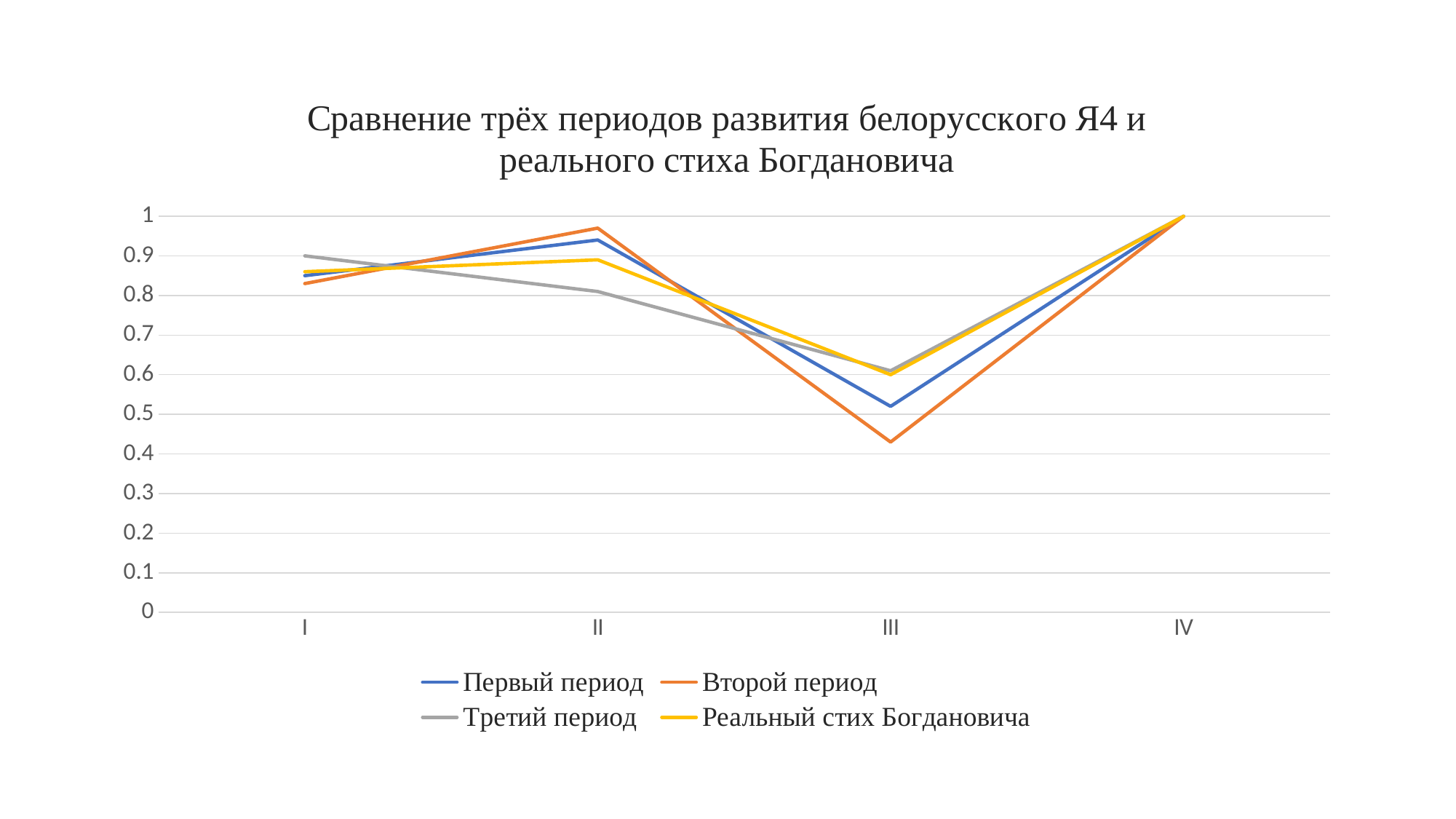
What is the value of Третий период at category I? 0.9 Is the value for Третий период at category II greater or less than 0.7? greater Is the value for Второй период at category III greater or less than 0.5? less Does the Второй период line rise or fall from category II to category III? fall What kind of chart is shown on the slide? line chart What is the value of Первый период at category IV? 1 Which series has the lowest value at category III? Второй период Is the value for Второй период at category II greater or less than 0.9? greater How many categories are shown on the x axis? 4 At category III, which is larger: Первый период or Второй период? Первый период How many series does the legend list? 4 Which series has the highest value at category I? Третий период